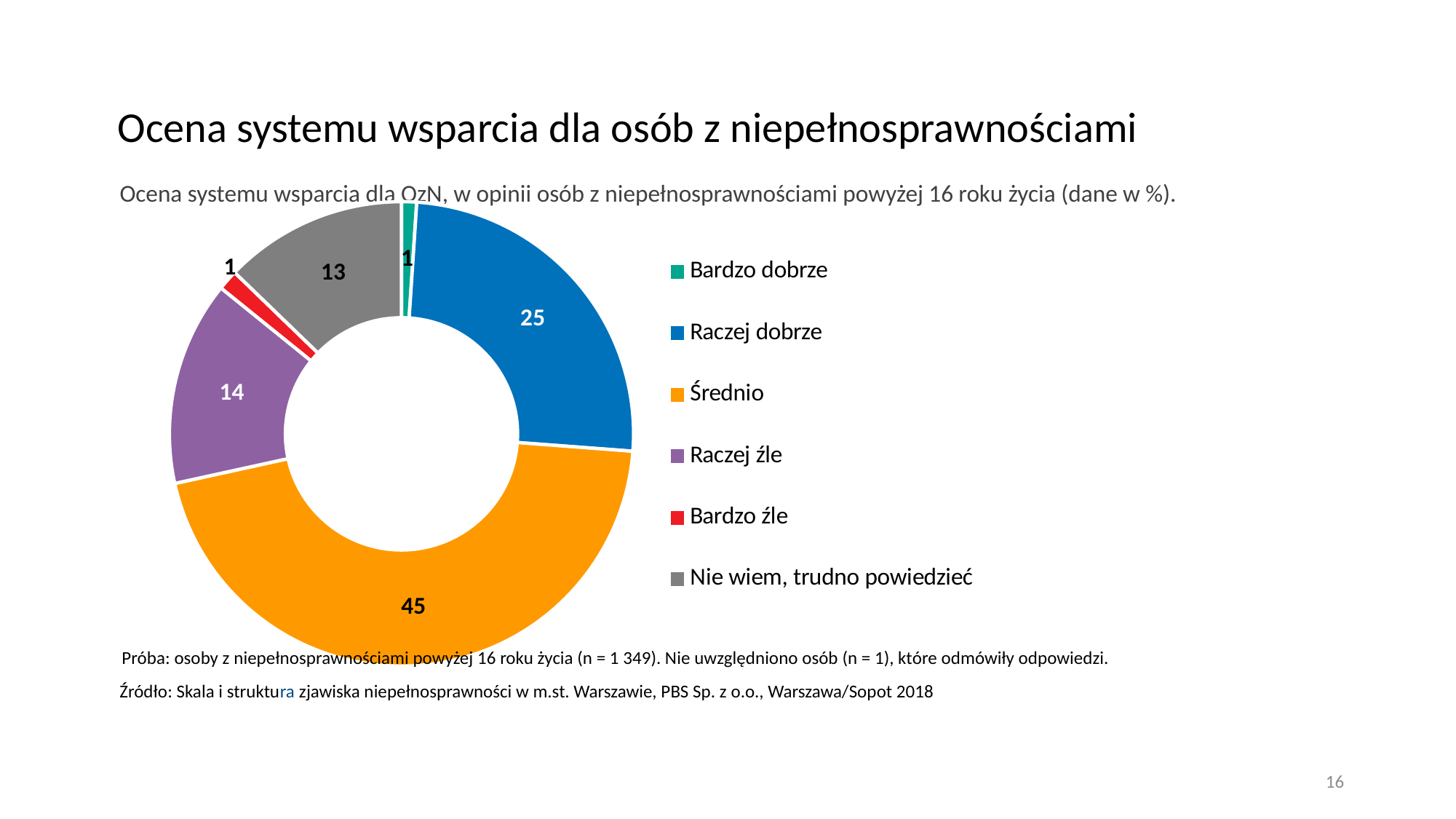
What is the difference between the values for "Raczej dobrze" and "Raczej źle"? 11 What colour is the "Bardzo źle" slice? Red What is the value for "Nie wiem, trudno powiedzieć"? 13 What is the difference between the values for "Średnio" and "Raczej dobrze"? 20 Which category has the largest share of the chart? Średnio What is the value for "Bardzo dobrze"? 1 Which is larger, the value for "Raczej źle" or the value for "Nie wiem, trudno powiedzieć"? Raczej źle What kind of chart is shown on the slide? Pie chart (doughnut) What is the value for "Raczej dobrze"? 25 What is the value for "Raczej źle"? 14 How many categories does the legend list? 6 What is the value for "Średnio"? 45